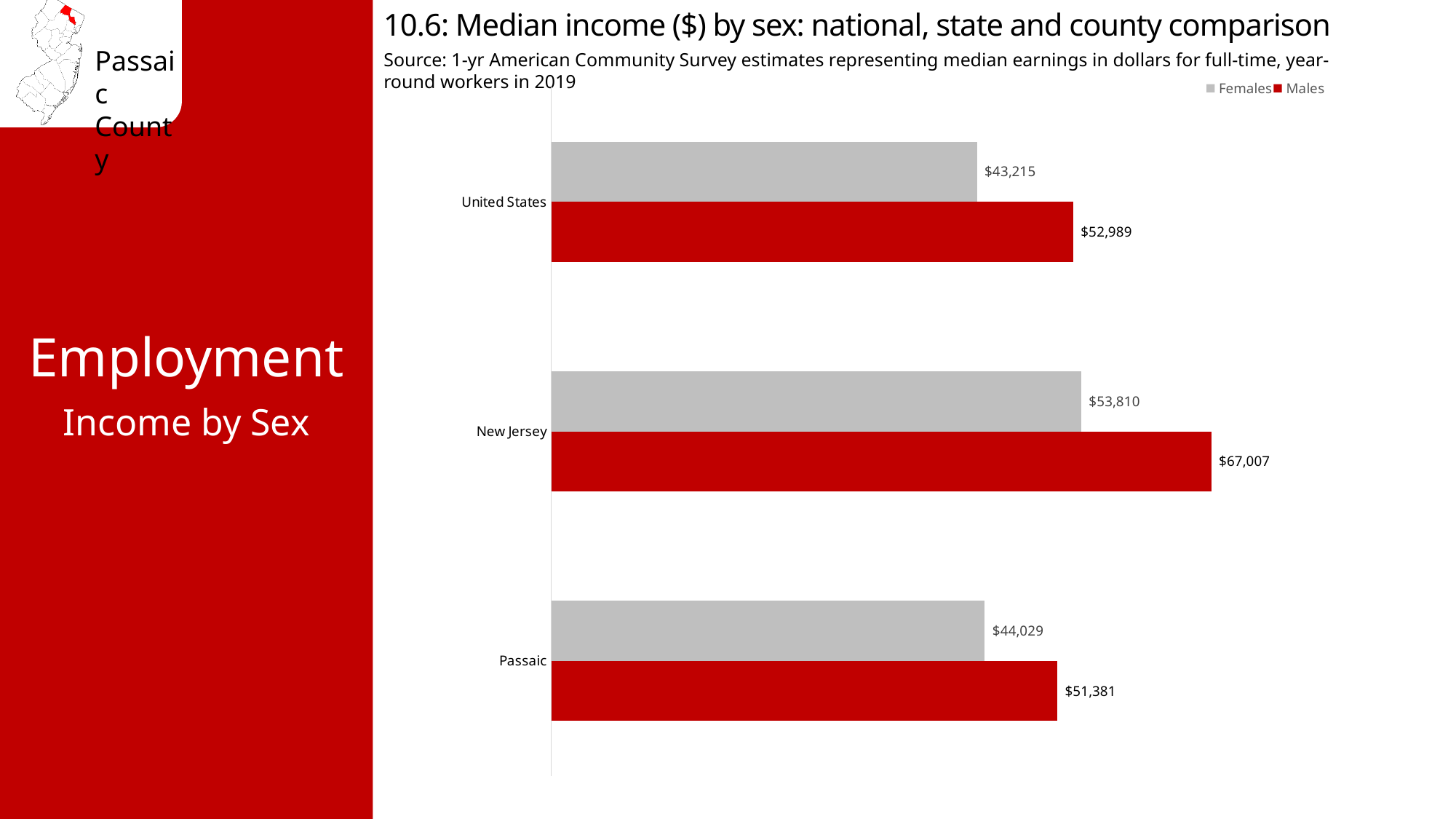
Which geography has the lowest median income for females? United States What kind of chart is shown on the slide? Bar chart What is the median income for males in New Jersey? $67,007 How many series does the legend list? 2 Which geography has the highest median income for males? New Jersey What is the median income for females in Passaic? $44,029 What is the difference between male median income in the United States and in Passaic? $1,608 What is the median income for females in the United States? $43,215 How many geographies are shown on the chart? 3 What is the median income for males in Passaic? $51,381 What is the difference between male and female median income in New Jersey? $13,197 Which is larger: female median income in New Jersey or male median income in the United States? Female median income in New Jersey